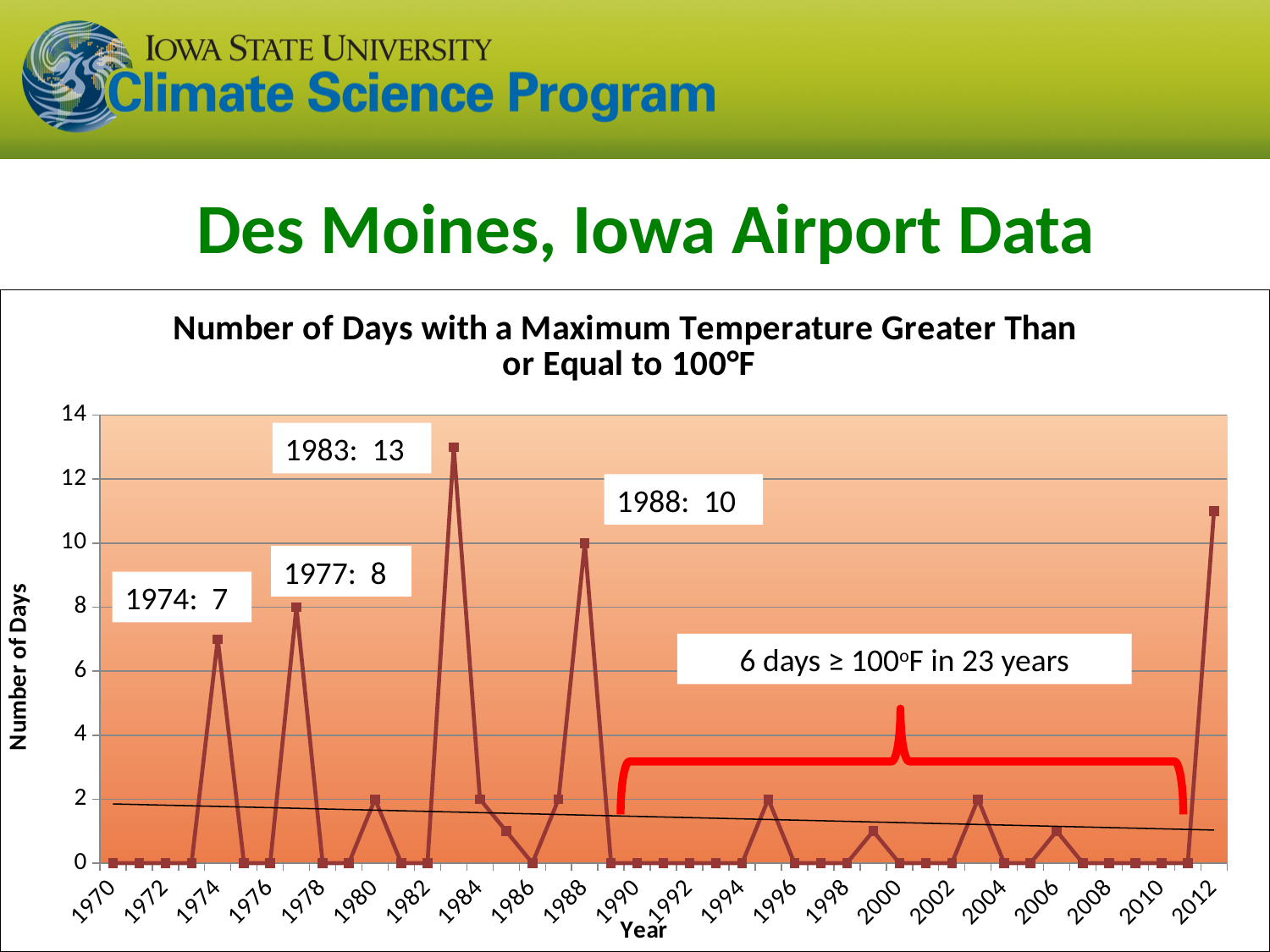
According to the annotation on the chart, how many days with a maximum temperature of at least 100°F were there in 1983? 13 What is the title of the chart? Number of Days with a Maximum Temperature Greater Than or Equal to 100°F How many days are labeled for 1977 on the chart? 8 What kind of chart is shown on the slide? line chart What value does the chart annotation give for 1988? 10 What is the label on the vertical axis of the chart? Number of Days Which year had more days at or above 100°F, 1974 or 1977? 1977 What is the difference between the labeled values for 1983 and 1988? 3 Is the value for 2012 greater or less than 10? greater What is the labeled number of days for 1974? 7 Which year has the highest number of days with a maximum temperature of 100°F or more? 1983 How many days at or above 100°F does the chart show for 1980? 2